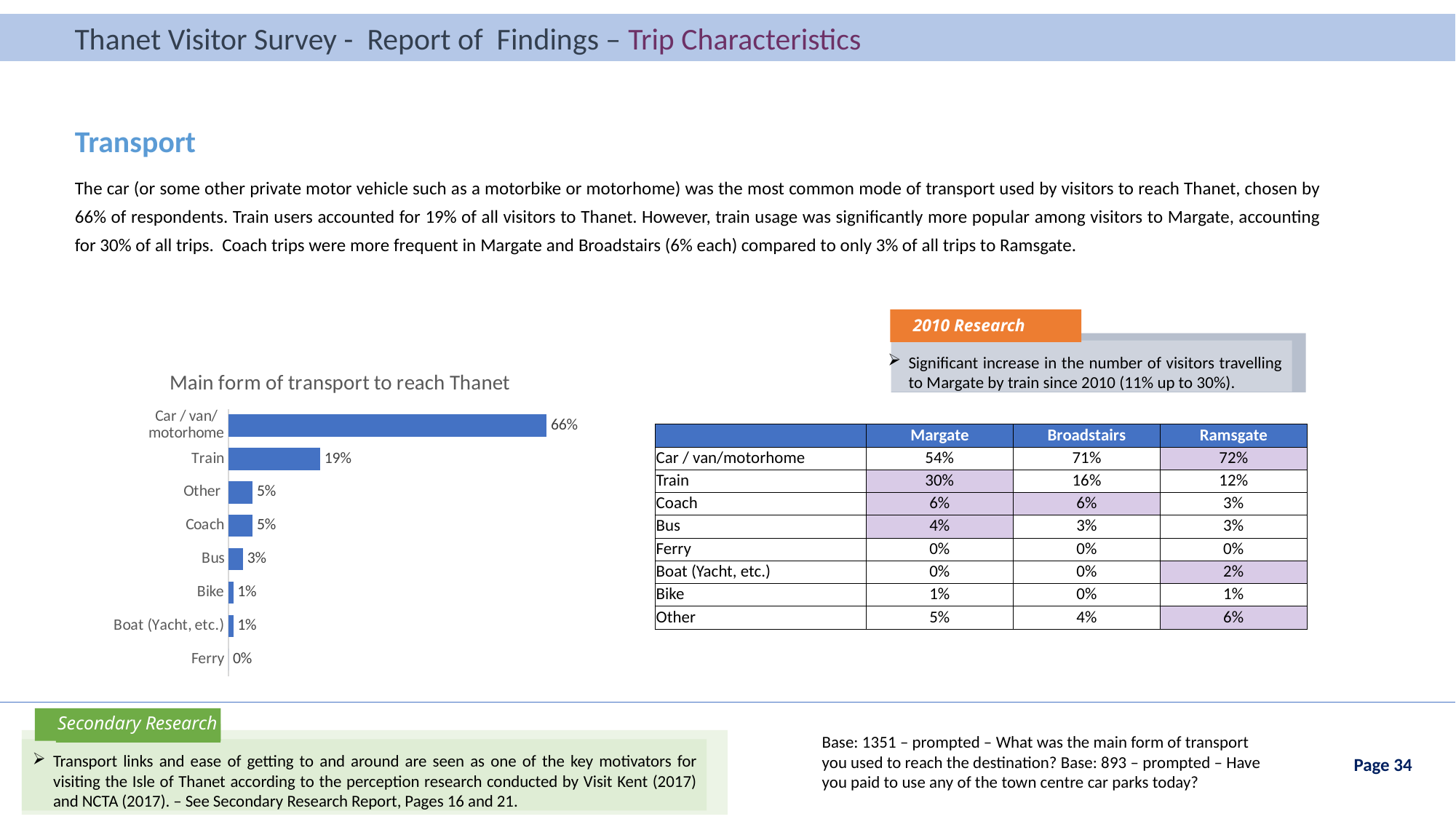
What is the value for Ferry in the chart? 0% What is the difference between the values for Car / van/ motorhome and Train? 47% Which is larger in the chart, the value for Train or the value for Coach? Train What is the value for Train in the chart? 19% What is the value for Bus in the chart? 3% What kind of chart is shown on the slide? Bar chart What is the title of the chart? Main form of transport to reach Thanet How many categories are shown in the chart? 8 Which category has the lowest value in the chart? Ferry What is the value for Car / van/ motorhome in the chart? 66% What is the difference between the values for Other and Bus in the chart? 2% Which category has the highest value in the chart? Car / van/ motorhome